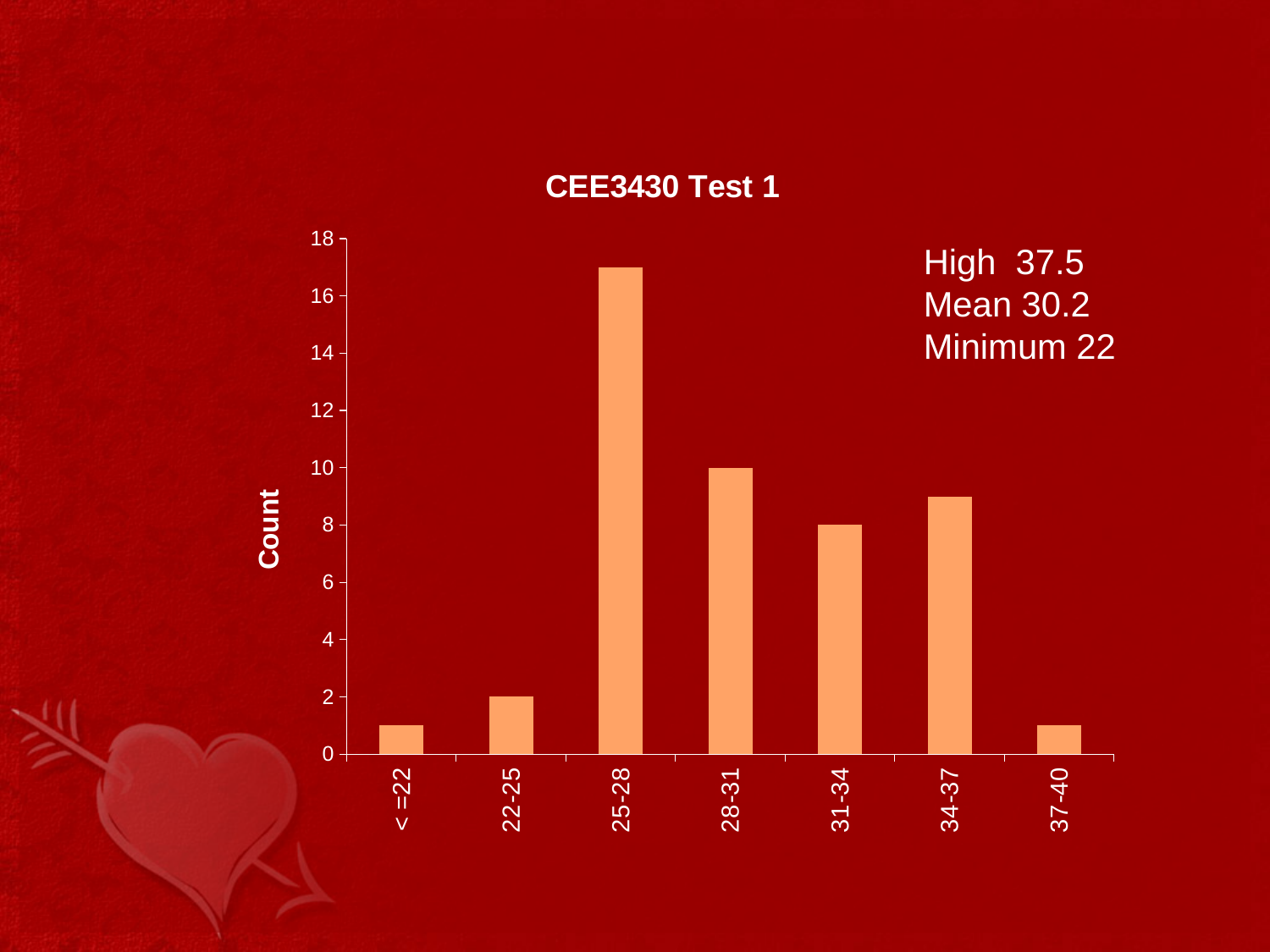
What is the title of the chart? CEE3430 Test 1 What is the count for the 22-25 score range? 2 What is the count for the 31-34 score range? 8 Which score range has the highest count? 25-28 Is the count for the 25-28 score range greater or less than 16? greater What is the difference between the counts for the 28-31 and 31-34 score ranges? 2 How many score ranges (categories) are shown on the x axis? 7 What is the count for the 28-31 score range? 10 Is the count for the 37-40 score range greater or less than 2? less What type of chart is shown on the slide? bar chart Is the count for the 34-37 score range greater or less than 10? less Which has a higher count, the 28-31 range or the 31-34 range? 28-31